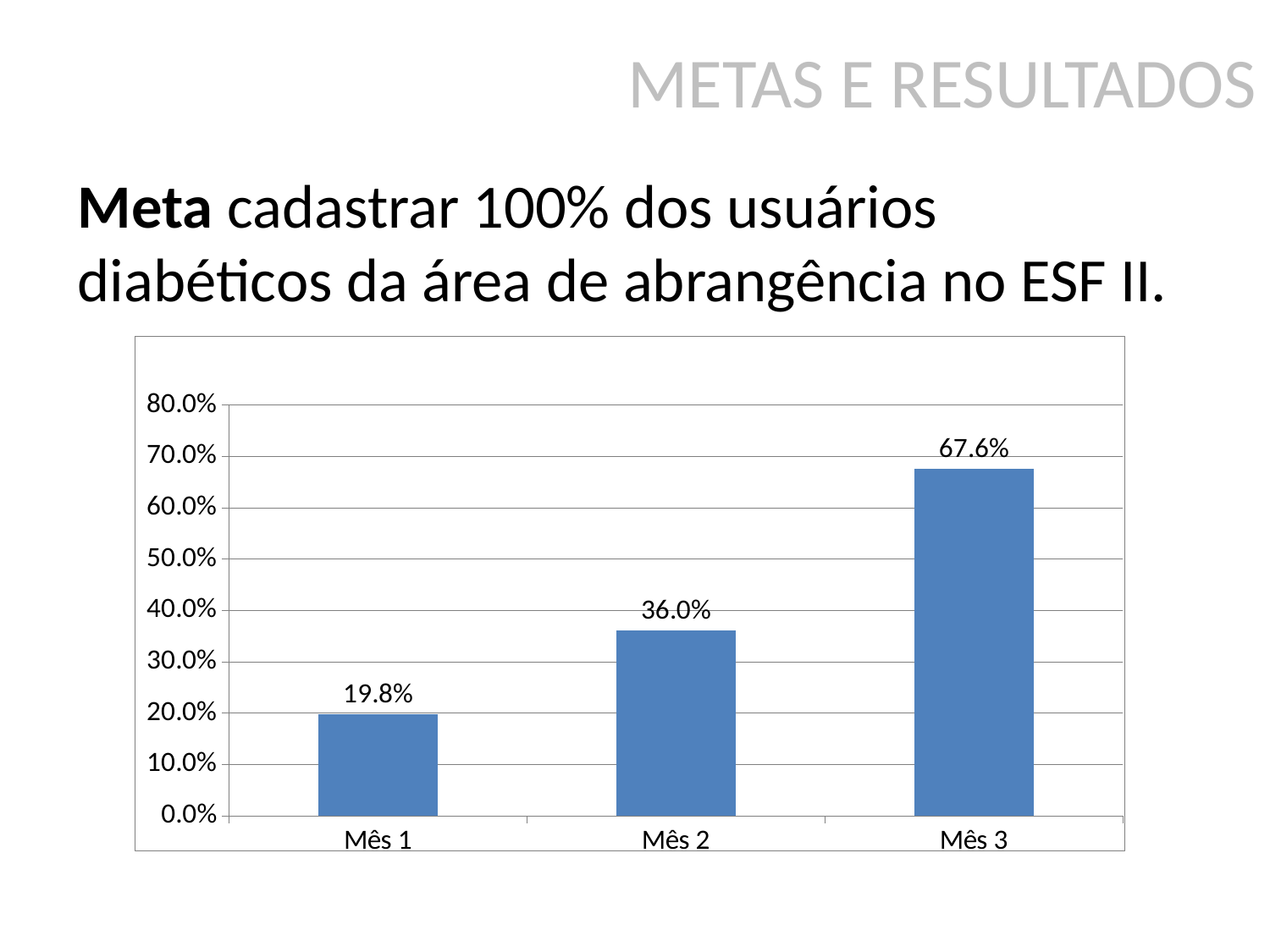
Which is larger, the value for Mês 1 or the value for Mês 2? Mês 2 What kind of chart is shown on the slide? bar chart Is the value for Mês 3 greater or less than 60.0%? greater What is the value for Mês 2? 36.0% Do the values rise or fall from Mês 1 to Mês 3? rise What is the difference between the values for Mês 3 and Mês 2? 31.6% Which month has the highest value? Mês 3 Which month has the lowest value? Mês 1 How many months are shown on the x axis? 3 What is the value for Mês 3? 67.6% What is the difference between the values for Mês 2 and Mês 1? 16.2% What is the value for Mês 1? 19.8%